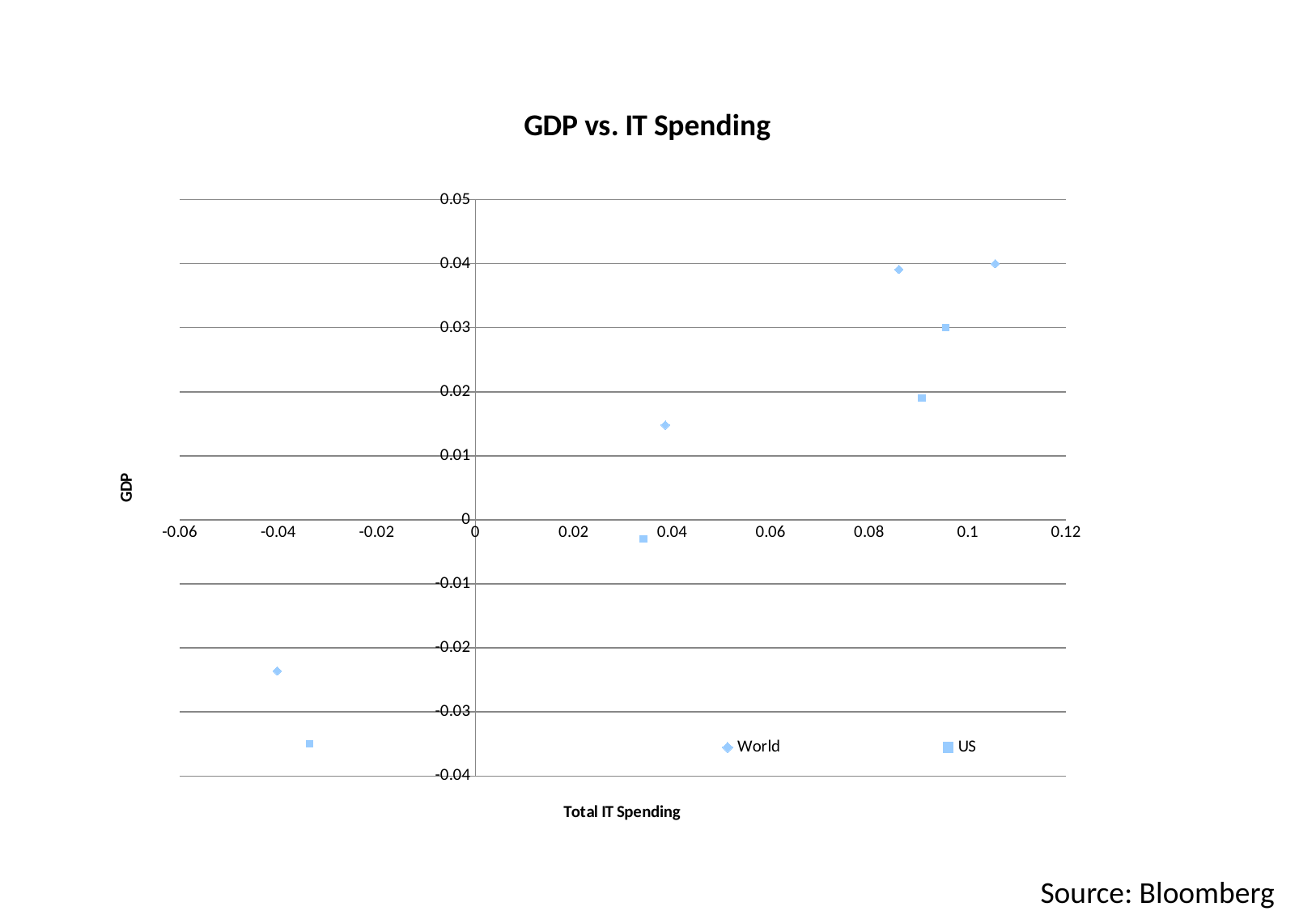
How many series does the legend list? 2 Is the GDP value of the World point near 0.04 Total IT Spending greater or less than 0.01? greater How many data points are plotted in total on the chart? 8 What kind of chart is shown on the slide? Scatter chart How many data points are plotted for the US series? 4 What is the title of the chart? GDP vs. IT Spending Is the GDP value of the World point with negative IT spending greater or less than -0.02? less Is the GDP value of the US point near 0.04 Total IT Spending greater or less than 0? less What are the two series named in the legend? World and US As Total IT Spending increases along the x axis, does GDP generally rise or fall? rise How many data points are plotted for the World series? 4